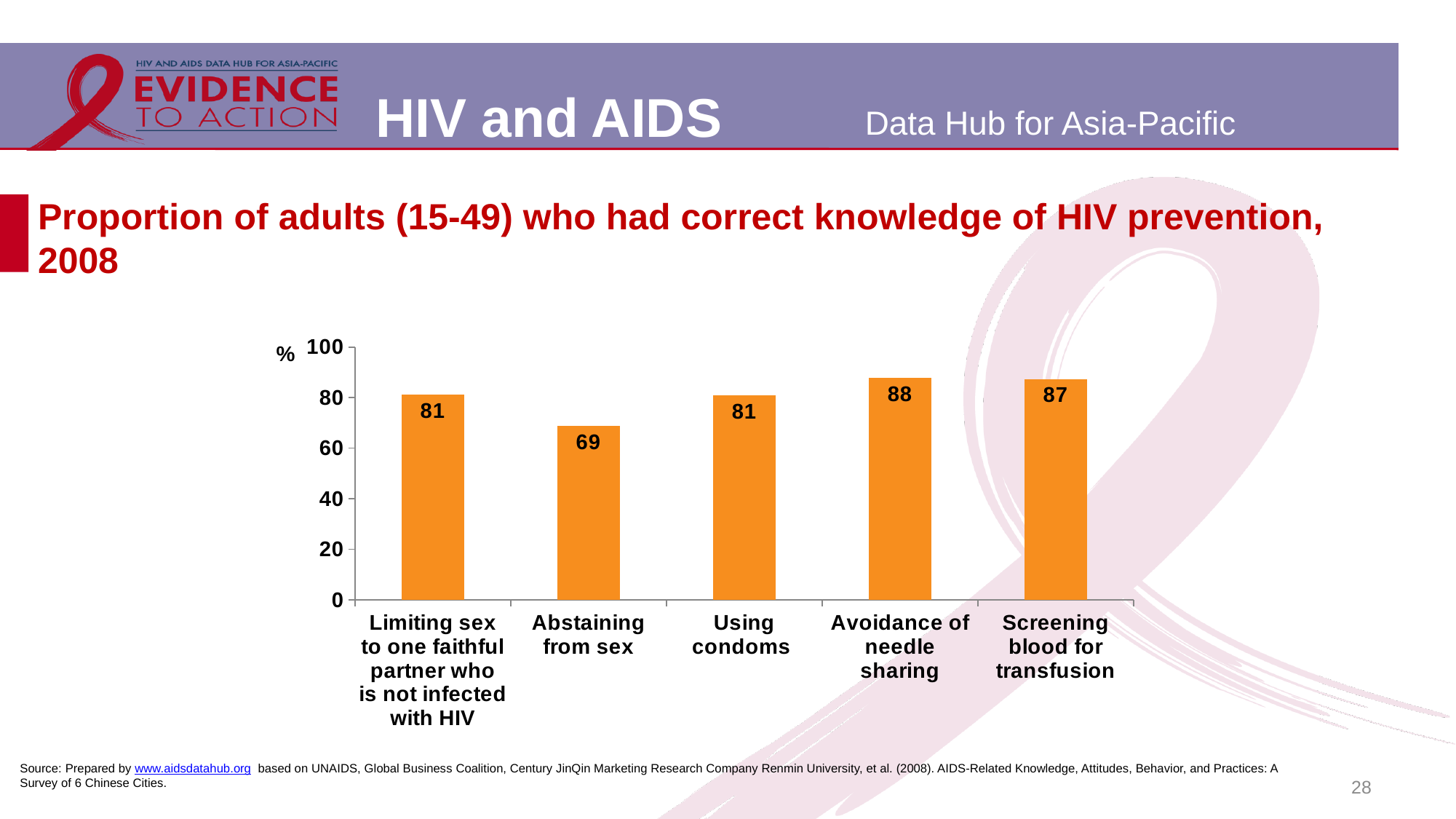
What kind of chart is shown on the slide? Bar chart Which category has the lowest value? Abstaining from sex What is the value for Abstaining from sex? 69 What is the value for Using condoms? 81 What is the value for Screening blood for transfusion? 87 What unit is shown on the y axis of the chart? % Is the value for Abstaining from sex greater or less than 80? less Which category has the highest value? Avoidance of needle sharing Which is larger, the value for Using condoms or the value for Abstaining from sex? Using condoms How many categories are shown in the chart? 5 What is the value for Avoidance of needle sharing? 88 What is the difference between the values for Avoidance of needle sharing and Abstaining from sex? 19